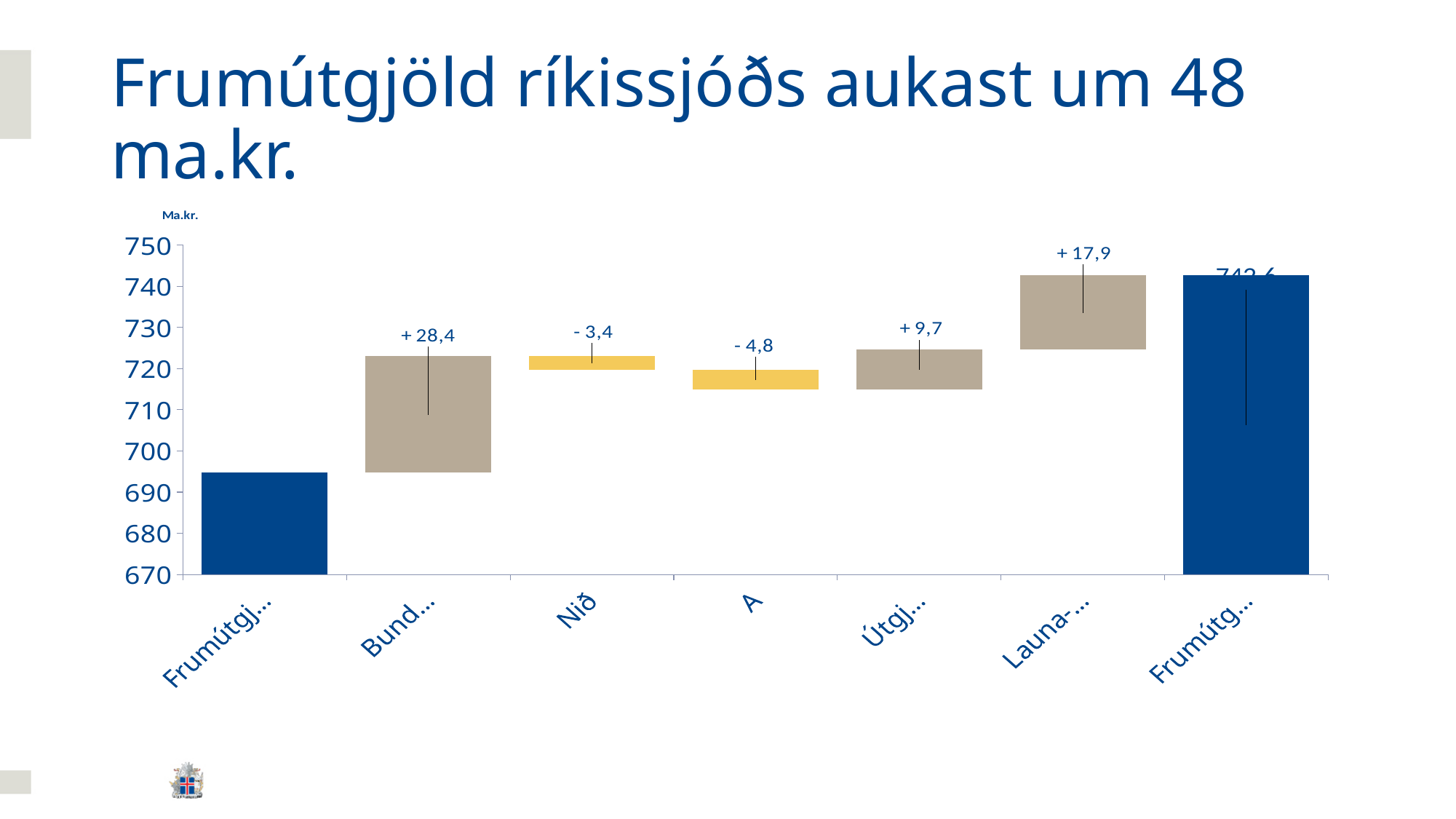
Is the value of the first bar (Frumútgj...) greater or less than 700? less What value is labelled on the sixth bar (Launa-...)? + 17,9 Which of the labelled changes is the largest increase? + 28,4 Is the value of the last bar (Frumútg...) greater or less than 740? greater What value is labelled on the second bar (Bund...)? + 28,4 How many bars are plotted in the chart? 7 What value is labelled on the bar for A? - 4,8 What kind of chart is shown on the slide? bar chart What value is labelled on the fifth bar (Útgj...)? + 9,7 How much larger is the increase labelled + 28,4 than the increase labelled + 17,9? 10,5 What unit label is shown above the vertical axis? Ma.kr. What value is labelled on the bar for Nið? - 3,4